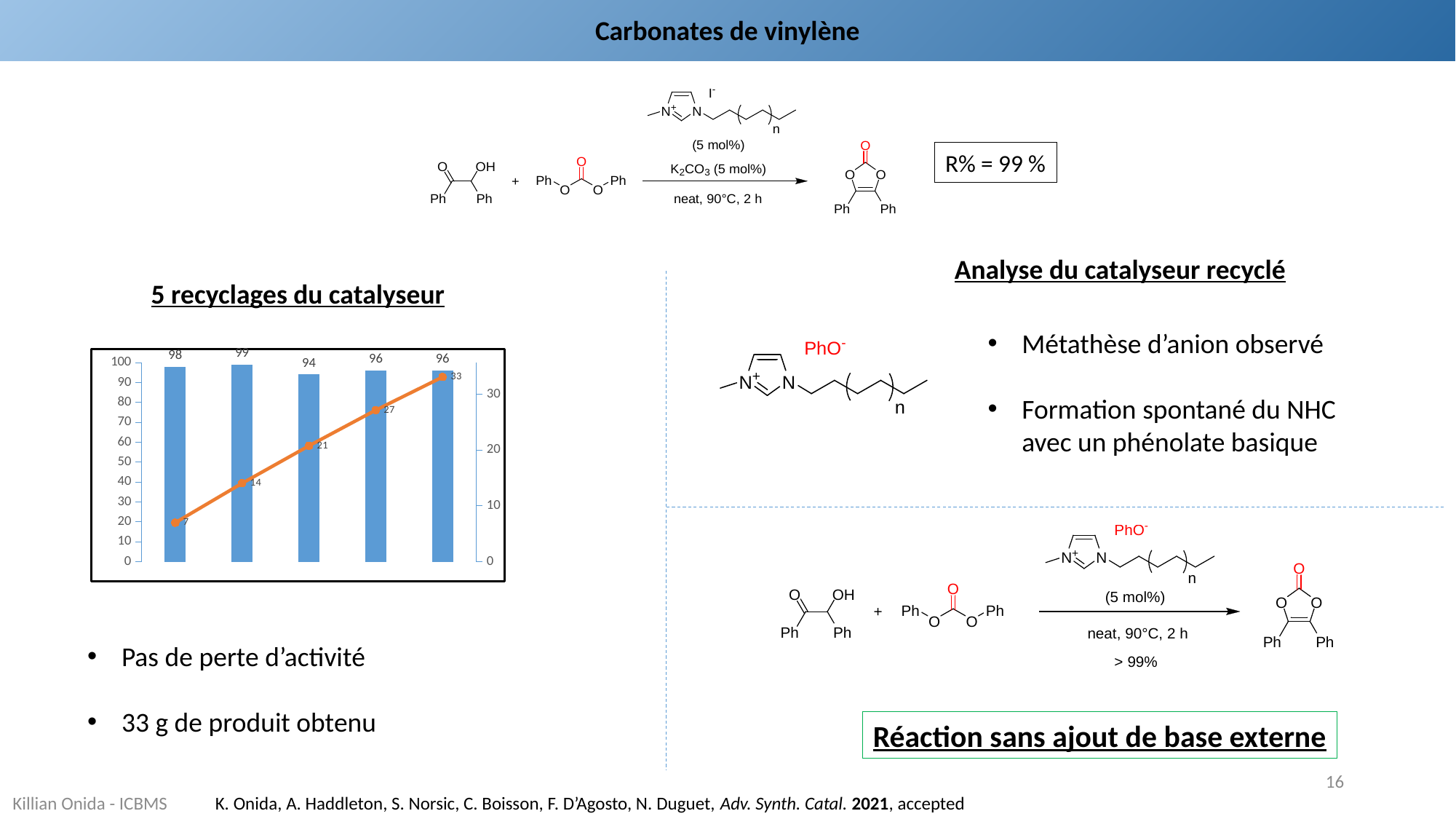
What is the difference between the labelled values of the second bar (99) and the third bar (94)? 5 What is the value labelled on the first (leftmost) point of the orange line? 7 Does the orange line rise or fall from left to right? Rises What kind of chart is shown under "5 recyclages du catalyseur"? A bar chart with an overlaid line What is the value labelled on the second bar from the left in the chart? 99 What is the value labelled on the last (rightmost) point of the orange line? 33 How many bars are plotted in the chart under "5 recyclages du catalyseur"? 5 Is the value of the third bar greater or less than 90 on the left axis? greater Which bar has the highest labelled value in the chart? The second bar (99) Which bar has the lowest labelled value in the chart? The third bar (94) What is the value labelled on the third bar from the left in the chart? 94 Which is larger, the labelled value of the first bar or the third bar? The first bar (98)